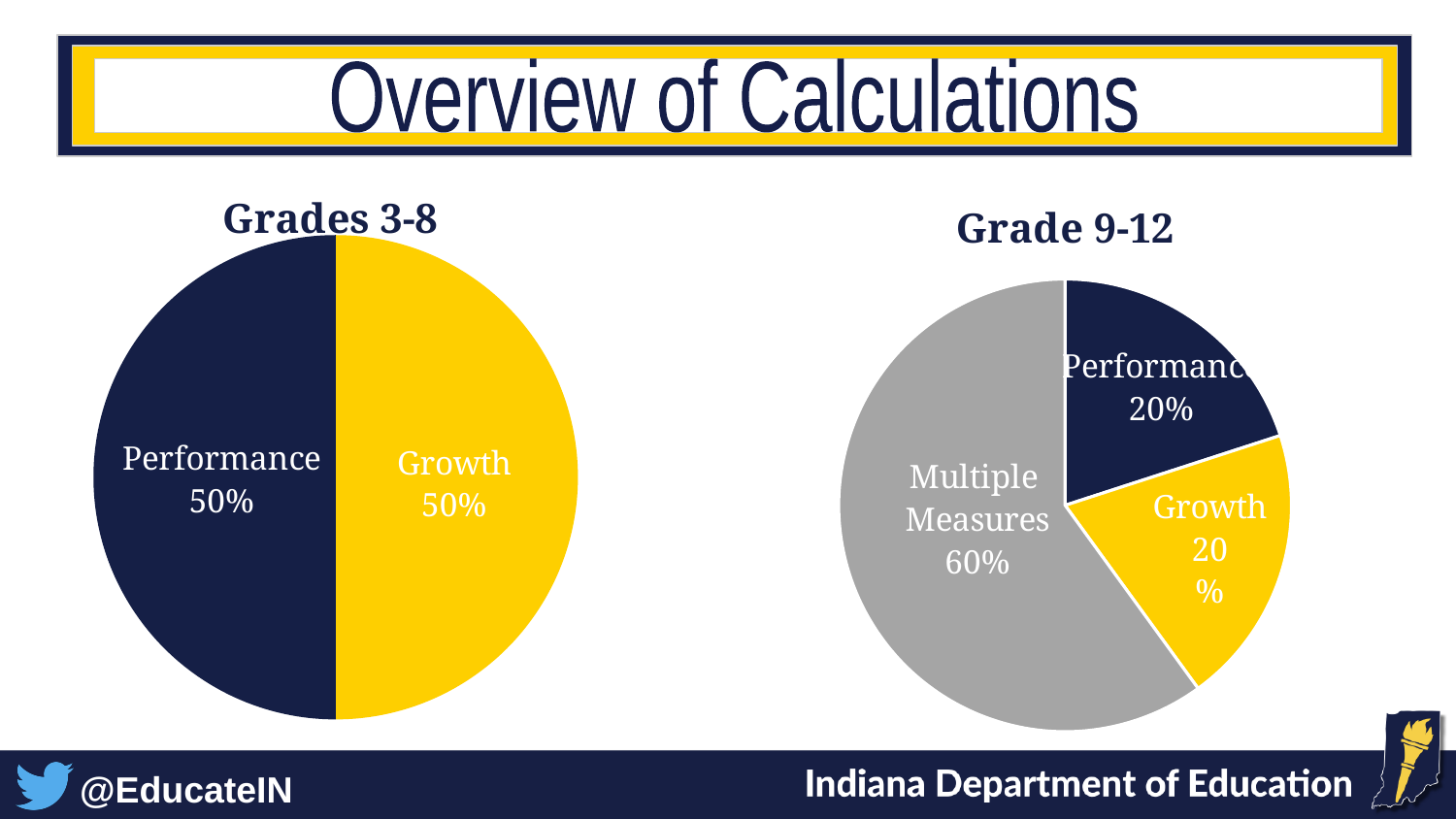
In the Grade 9-12 chart, what share does Multiple Measures have? 60% In the Grades 3-8 chart, what share does Performance have? 50% What kind of chart is the Grades 3-8 chart? Pie chart How many slices does the Grade 9-12 chart have? 3 How many slices does the Grades 3-8 chart have? 2 In the Grade 9-12 chart, what share does Growth have? 20% In the Grade 9-12 chart, which is larger, Multiple Measures or Performance? Multiple Measures In the Grade 9-12 chart, what is the difference between the Multiple Measures share and the Growth share? 40% What is the title of the chart on the right side of the slide? Grade 9-12 In the Grades 3-8 chart, what share does Growth have? 50% In the Grade 9-12 chart, which slice is the largest? Multiple Measures In the Grade 9-12 chart, what share does Performance have? 20%